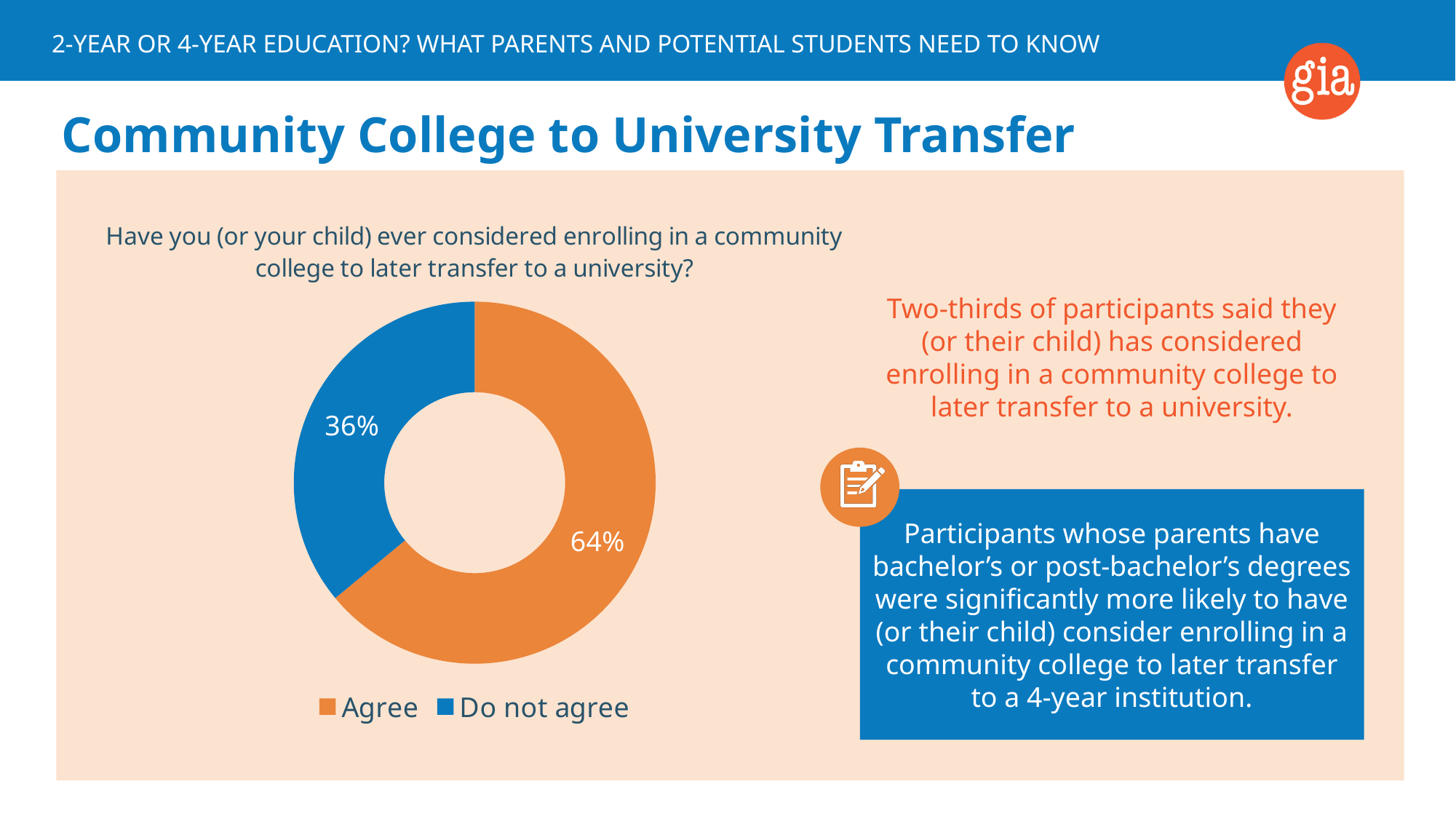
What colour is the "Agree" slice? Orange What question is the chart titled with? Have you (or your child) ever considered enrolling in a community college to later transfer to a university? How many categories does the chart show? 2 How many entries does the legend list? 2 What percentage of participants answered "Do not agree"? 36% Which response has the smaller share of the pie? Do not agree What is the difference in percentage points between "Agree" and "Do not agree"? 28 What percentage of participants answered "Agree"? 64% Is the share for "Agree" larger or smaller than the share for "Do not agree"? larger What kind of chart is shown on the slide? Pie chart (doughnut) Which response has the larger share of the pie? Agree What share of the pie does the "Do not agree" slice represent? 36%